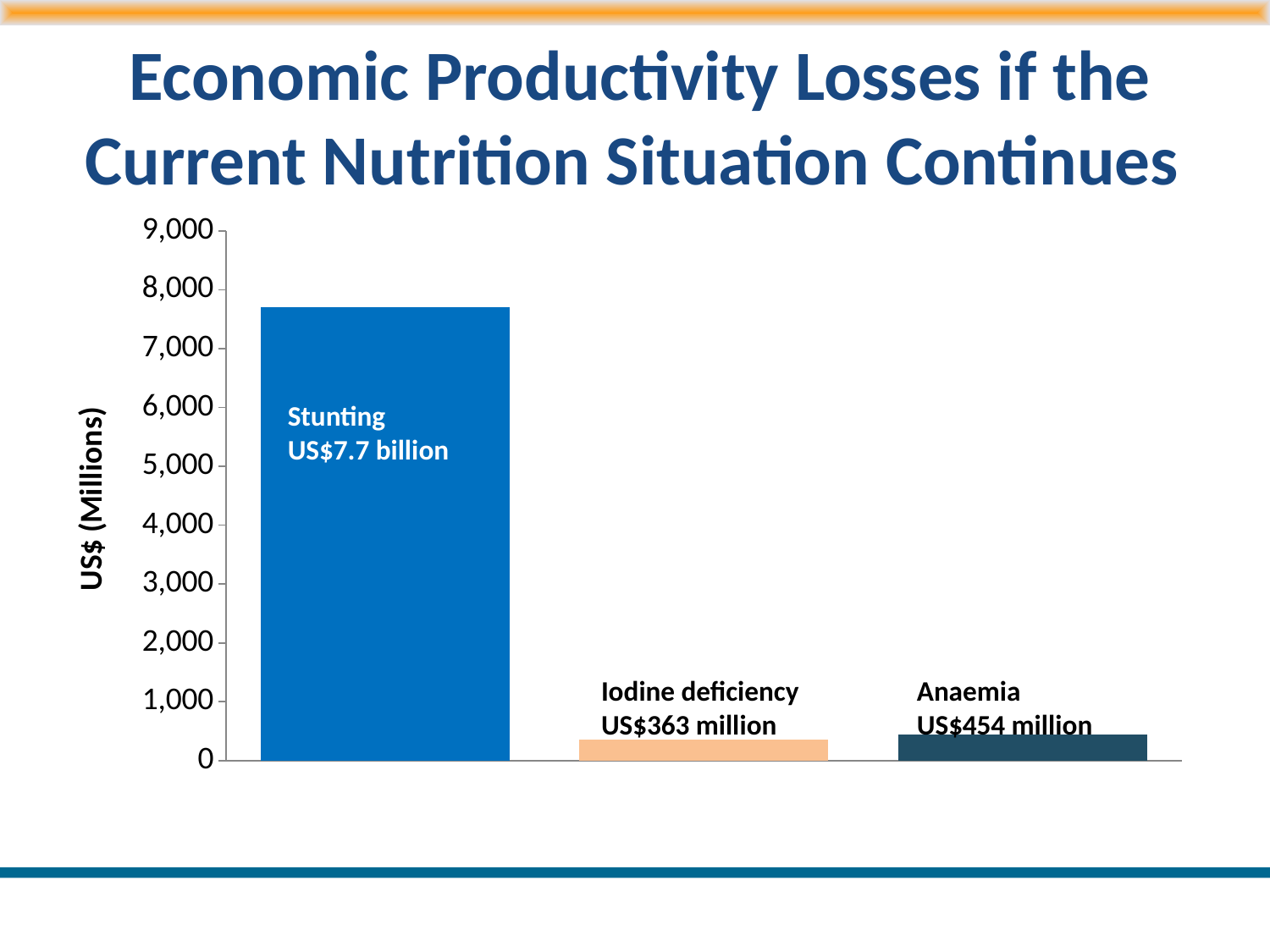
What kind of chart is shown on the slide? Bar chart What is the label on the vertical axis of the chart? US$ (Millions) Which category has the highest economic productivity loss? Stunting What is the economic productivity loss shown for Iodine deficiency? US$363 million How many categories are plotted in the chart? 3 Which has the larger economic productivity loss, Anaemia or Iodine deficiency? Anaemia Is the value for Anaemia greater or less than 1,000 on the axis? less What is the difference between the losses for Anaemia and Iodine deficiency? US$91 million Is the value for Stunting greater or less than 7,000 on the axis? greater What is the economic productivity loss shown for Anaemia? US$454 million What is the economic productivity loss shown for Stunting? US$7.7 billion Which category has the lowest economic productivity loss? Iodine deficiency